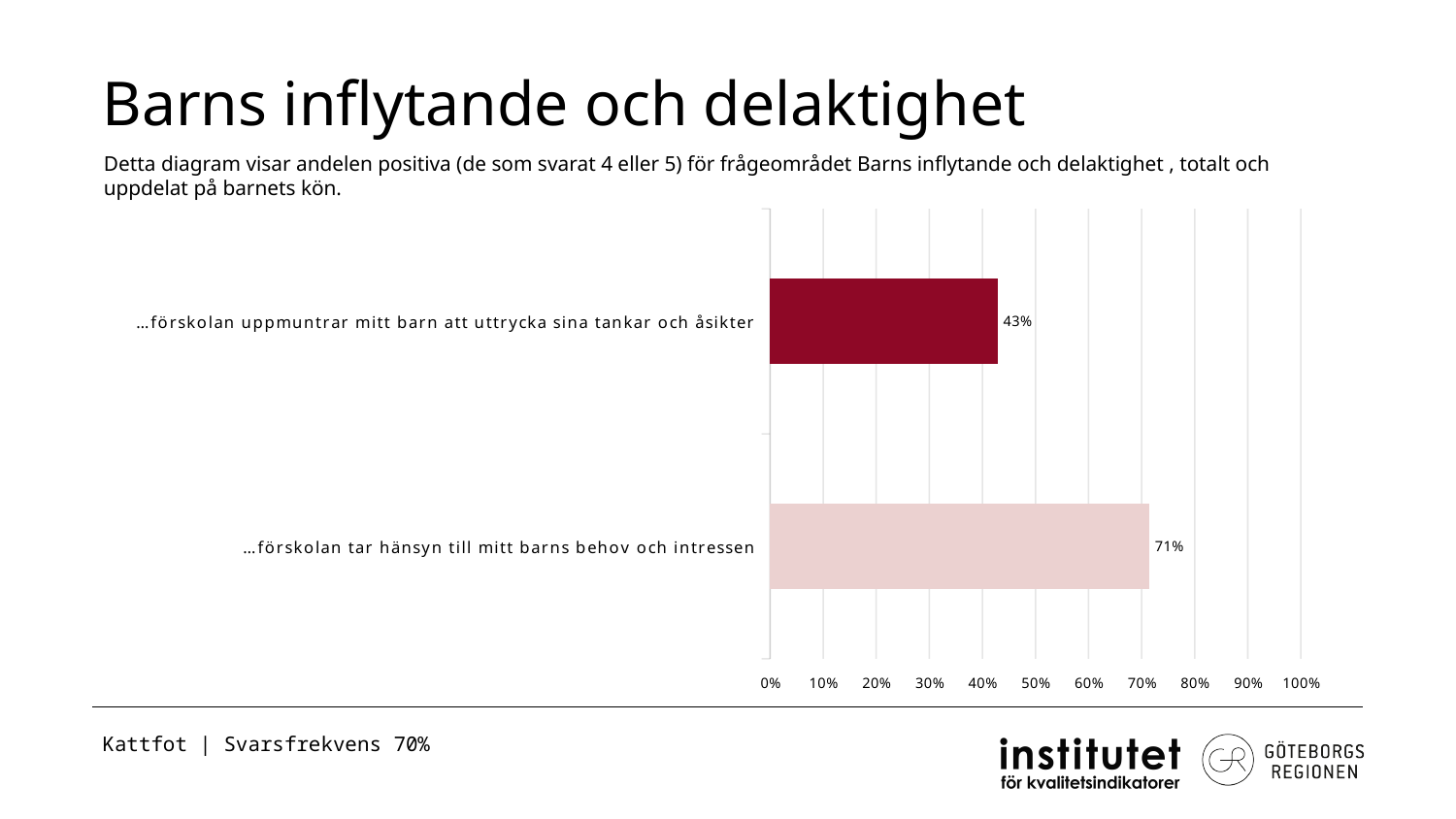
Which category has the highest value? …förskolan tar hänsyn till mitt barns behov och intressen What is the maximum value shown on the x axis of the chart? 100% What is the value for "…förskolan tar hänsyn till mitt barns behov och intressen"? 71% What is the difference between the values for "…förskolan tar hänsyn till mitt barns behov och intressen" and "…förskolan uppmuntrar mitt barn att uttrycka sina tankar och åsikter"? 28% Is the value for "…förskolan uppmuntrar mitt barn att uttrycka sina tankar och åsikter" greater or less than 50%? less Which category has the lowest value? …förskolan uppmuntrar mitt barn att uttrycka sina tankar och åsikter What is the title of the slide containing the chart? Barns inflytande och delaktighet What kind of chart is shown on the slide? Bar chart What is the value for "…förskolan uppmuntrar mitt barn att uttrycka sina tankar och åsikter"? 43% Which is larger: the value for "…förskolan uppmuntrar mitt barn att uttrycka sina tankar och åsikter" or the value for "…förskolan tar hänsyn till mitt barns behov och intressen"? …förskolan tar hänsyn till mitt barns behov och intressen How many categories are shown in the chart? 2 Is the value for "…förskolan tar hänsyn till mitt barns behov och intressen" greater or less than 60%? greater